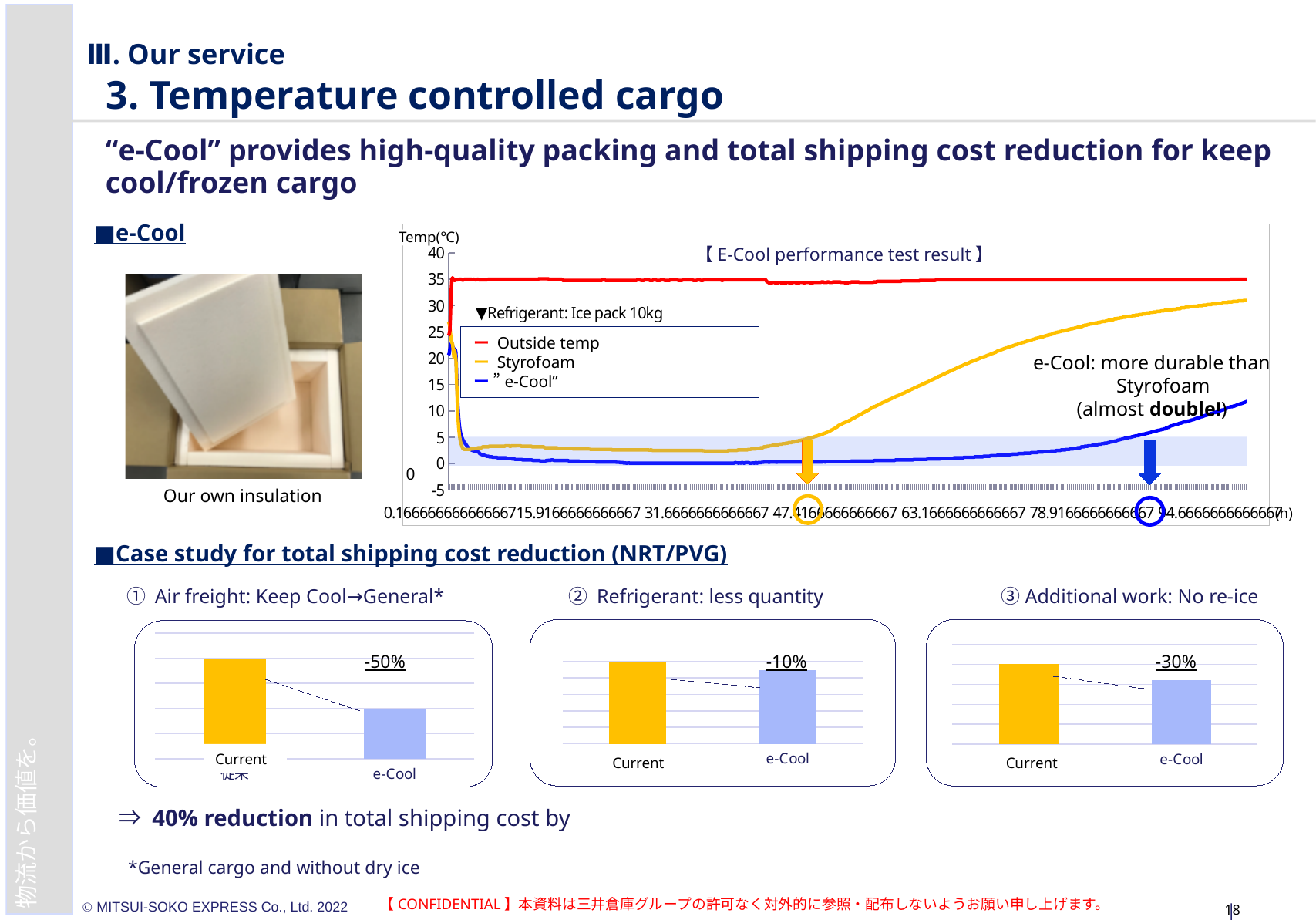
In the Refrigerant: less quantity chart, what percentage change is labelled between Current and e-Cool? -10% In the E-Cool performance test result chart, which series is lowest at the end of the test? e-Cool In the Air freight: Keep Cool→General chart, what percentage change is labelled between Current and e-Cool? -50% In the Additional work: No re-ice chart, which bar is taller, Current or e-Cool? Current What type of chart is the E-Cool performance test result chart? line chart In the E-Cool performance test result chart, which series stays highest throughout the test? Outside temp How many series does the legend of the E-Cool performance test result chart list? 3 In the E-Cool performance test result chart, is the e-Cool value at the end of the test greater or less than 20? less In the E-Cool performance test result chart, is the Outside temp value greater or less than 30? greater In the E-Cool performance test result chart, is the Styrofoam value at the end of the test greater or less than 25? greater What is the highest tick value on the vertical axis of the E-Cool performance test result chart? 40 In the E-Cool performance test result chart, does the Styrofoam temperature rise or fall over the second half of the test? rise